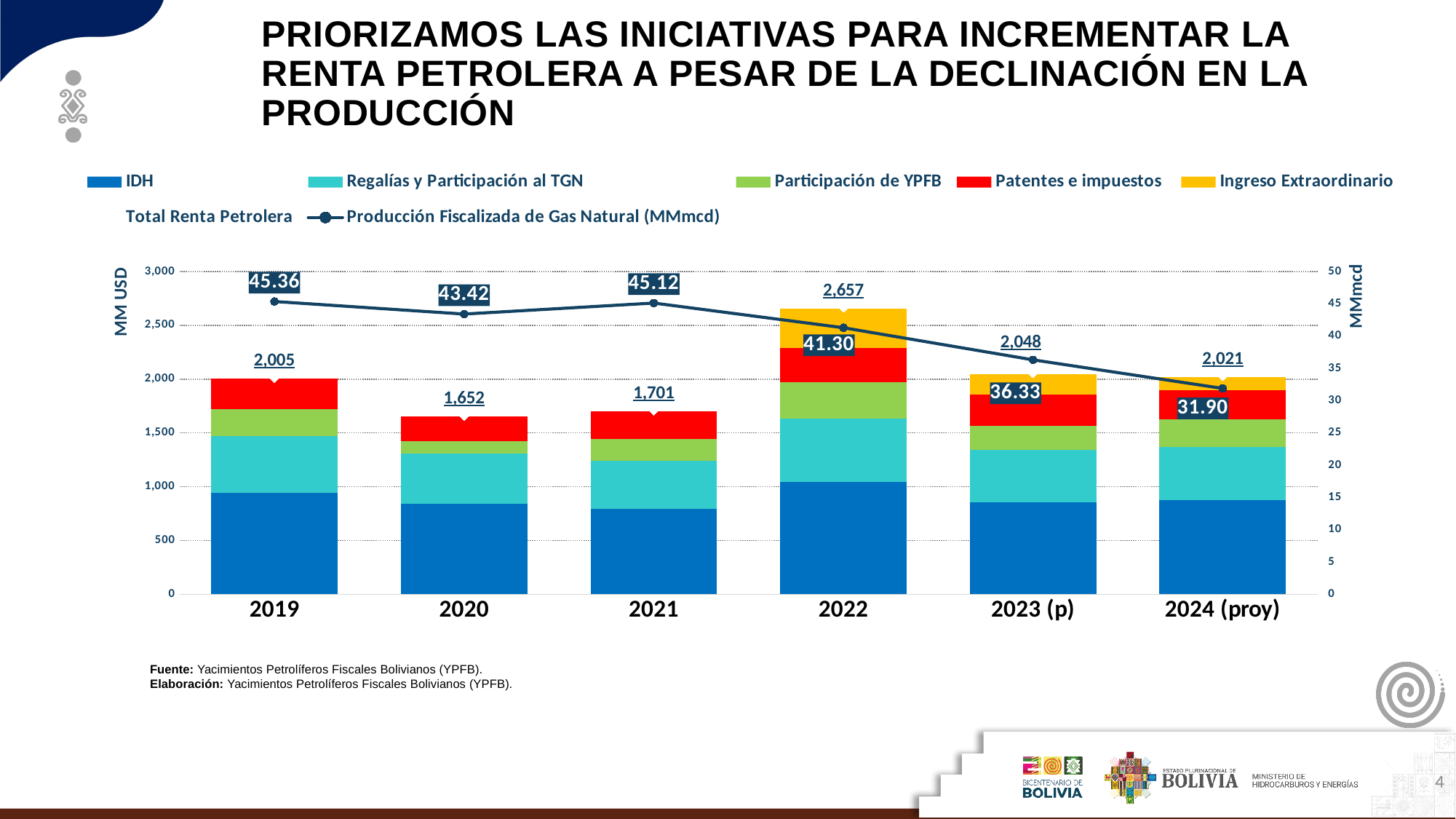
How many entries does the legend list? 7 Which year has the lowest Producción Fiscalizada de Gas Natural? 2024 (proy) What is the Total Renta Petrolera value for 2022? 2,657 Which is larger, the Total Renta Petrolera for 2019 or for 2021? 2019 What is the Producción Fiscalizada de Gas Natural value for 2024 (proy)? 31.90 What is the Total Renta Petrolera value for 2020? 1,652 What is the label of the left vertical axis? MM USD Does the Producción Fiscalizada de Gas Natural line rise or fall from 2021 to 2024 (proy)? fall What is the difference between the Total Renta Petrolera for 2022 and 2023 (p)? 609 How many years are shown on the x axis? 6 Which year has the highest Total Renta Petrolera? 2022